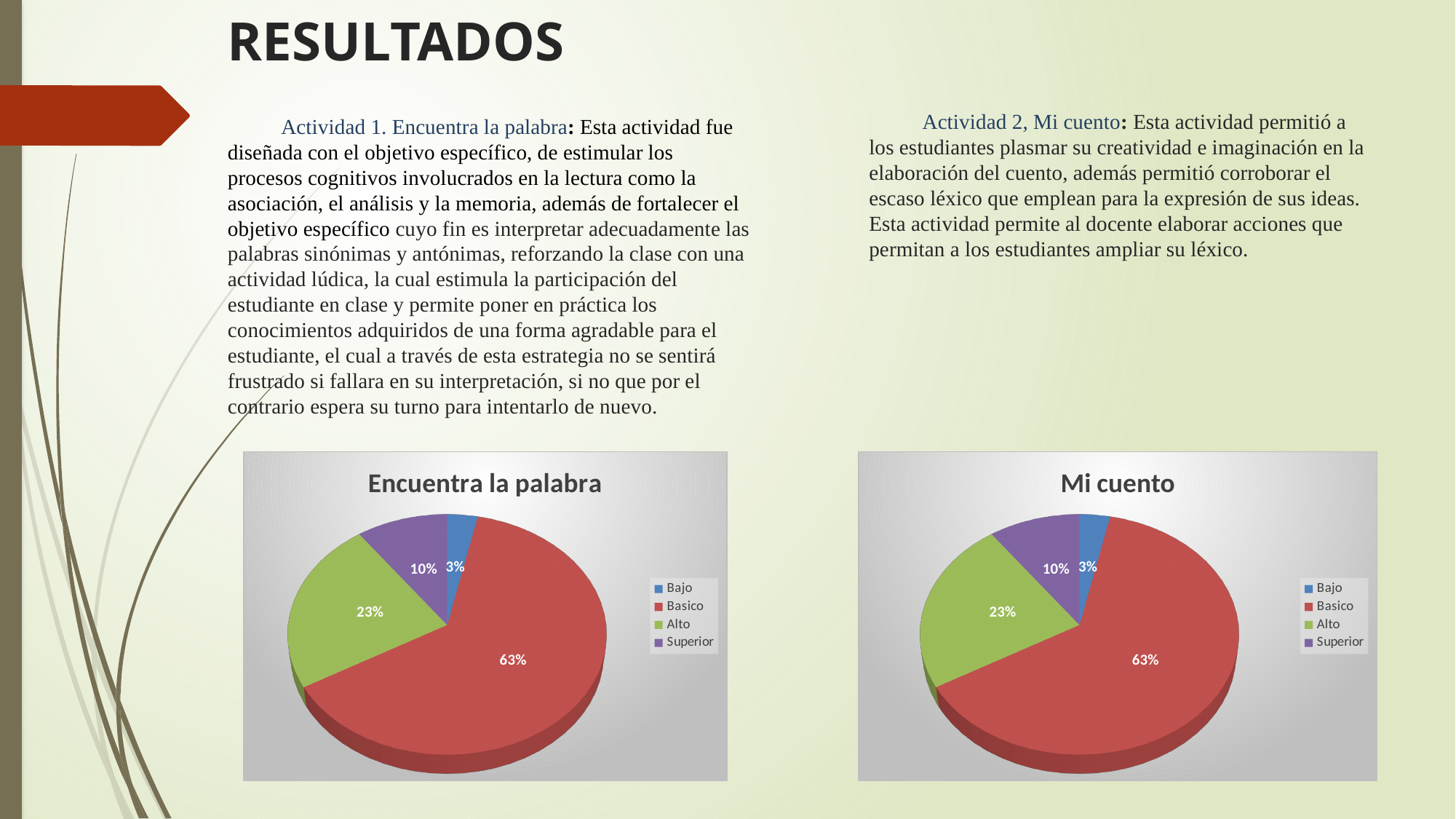
How many entries does the legend of the 'Encuentra la palabra' chart list? 4 In the 'Mi cuento' chart, which category has the smallest slice? Bajo In the 'Encuentra la palabra' chart, what share does Alto have? 23% In the 'Mi cuento' chart, what share does Bajo have? 3% In the 'Encuentra la palabra' chart, what share does Basico have? 63% What kind of chart is 'Encuentra la palabra'? Pie chart In the 'Encuentra la palabra' chart, what is the difference between the Basico and Alto shares? 40% In the 'Mi cuento' chart, which is larger, Alto or Superior? Alto In the 'Encuentra la palabra' chart, which category has the largest slice? Basico In the 'Mi cuento' chart, what colour is the Basico slice? Red In the 'Mi cuento' chart, what share does Superior have? 10% How many categories does the 'Mi cuento' chart show? 4